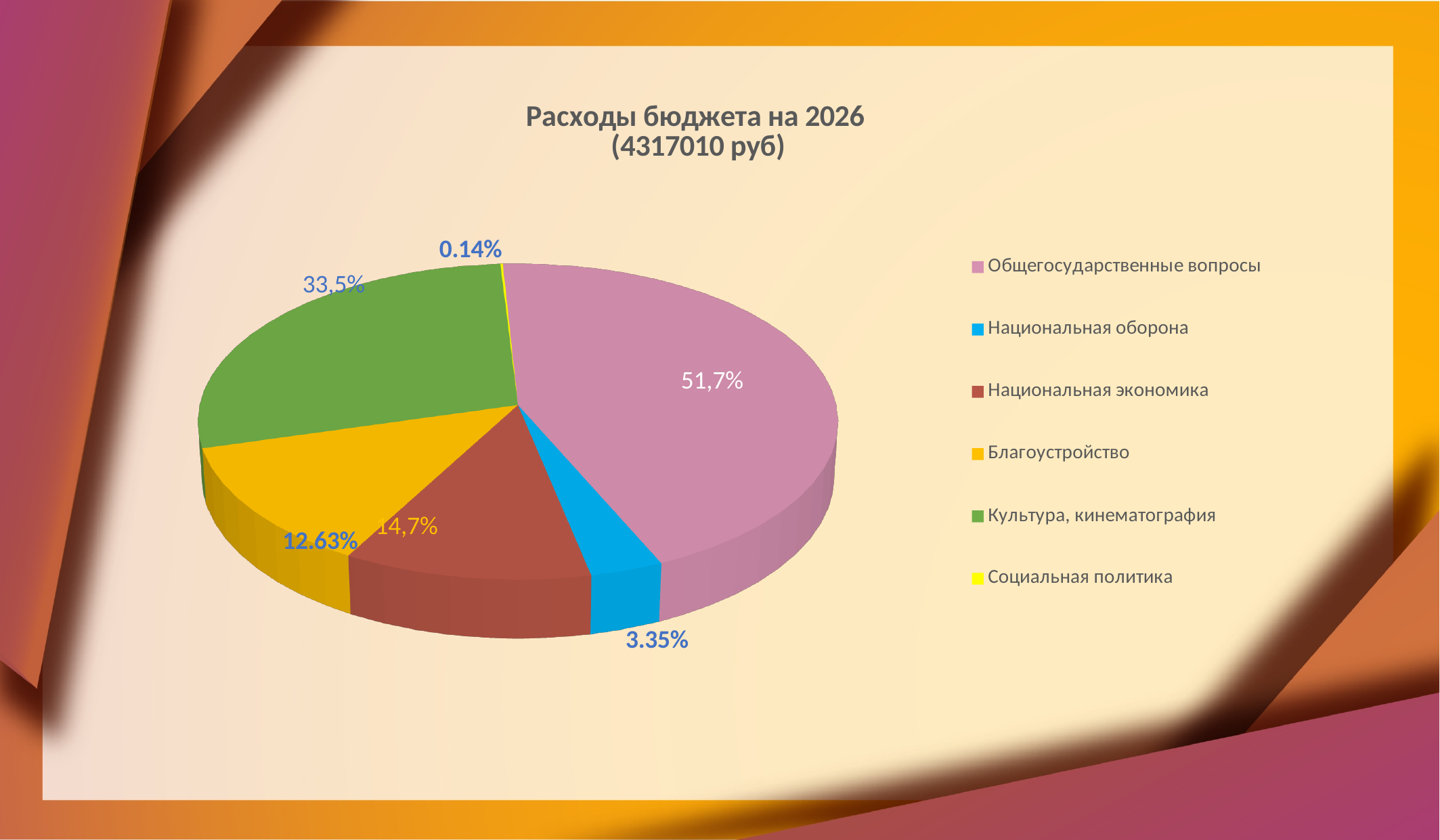
What share of the pie is labelled for Социальная политика? 0.14% What kind of chart is shown on the slide? pie chart What share of the pie is labelled for Общегосударственные вопросы? 51,7% What share of the pie is labelled for Национальная оборона? 3.35% What is the difference between the shares of Общегосударственные вопросы and Культура, кинематография? 18,2% How many categories does the legend of the pie chart list? 6 Which category has the smallest slice of the pie? Социальная политика What colour is the slice for Национальная оборона? blue Which slice is larger: Культура, кинематография or Национальная оборона? Культура, кинематография What is the title of the chart? Расходы бюджета на 2026 (4317010 руб) What share of the pie is labelled for Культура, кинематография? 33,5% Which category has the largest slice of the pie? Общегосударственные вопросы